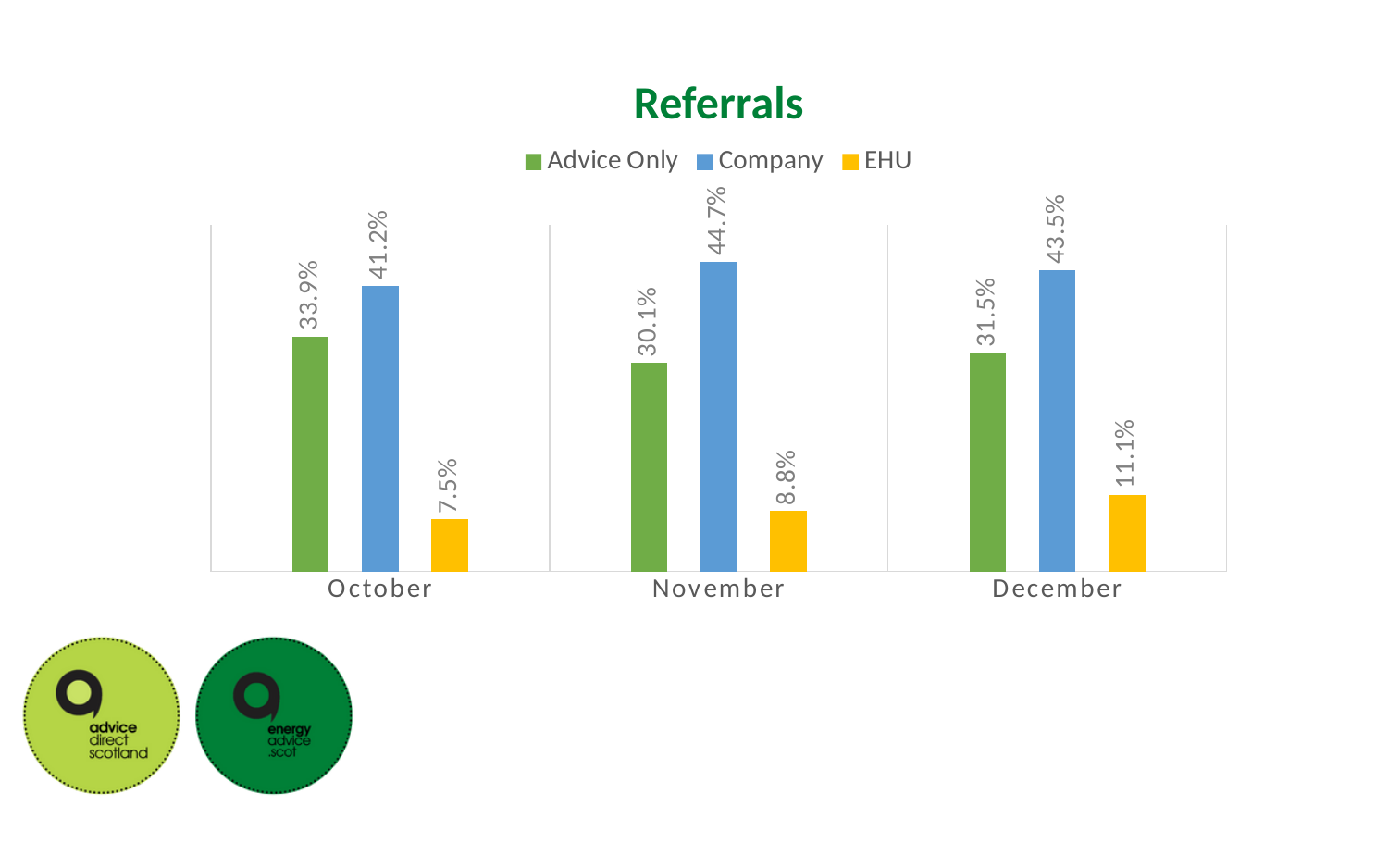
Which is larger in December, Advice Only or EHU? Advice Only What is the Company value for November? 44.7% What is the difference between the Company and Advice Only values in October? 7.3% What is the title of the chart? Referrals How many series does the legend list? 3 What is the EHU value for October? 7.5% What is the Advice Only value for December? 31.5% Does the EHU value rise or fall from October to December? Rise In which month is the Company value highest? November How many months are shown on the x axis? 3 What kind of chart is this? Bar chart In which month is the EHU value lowest? October